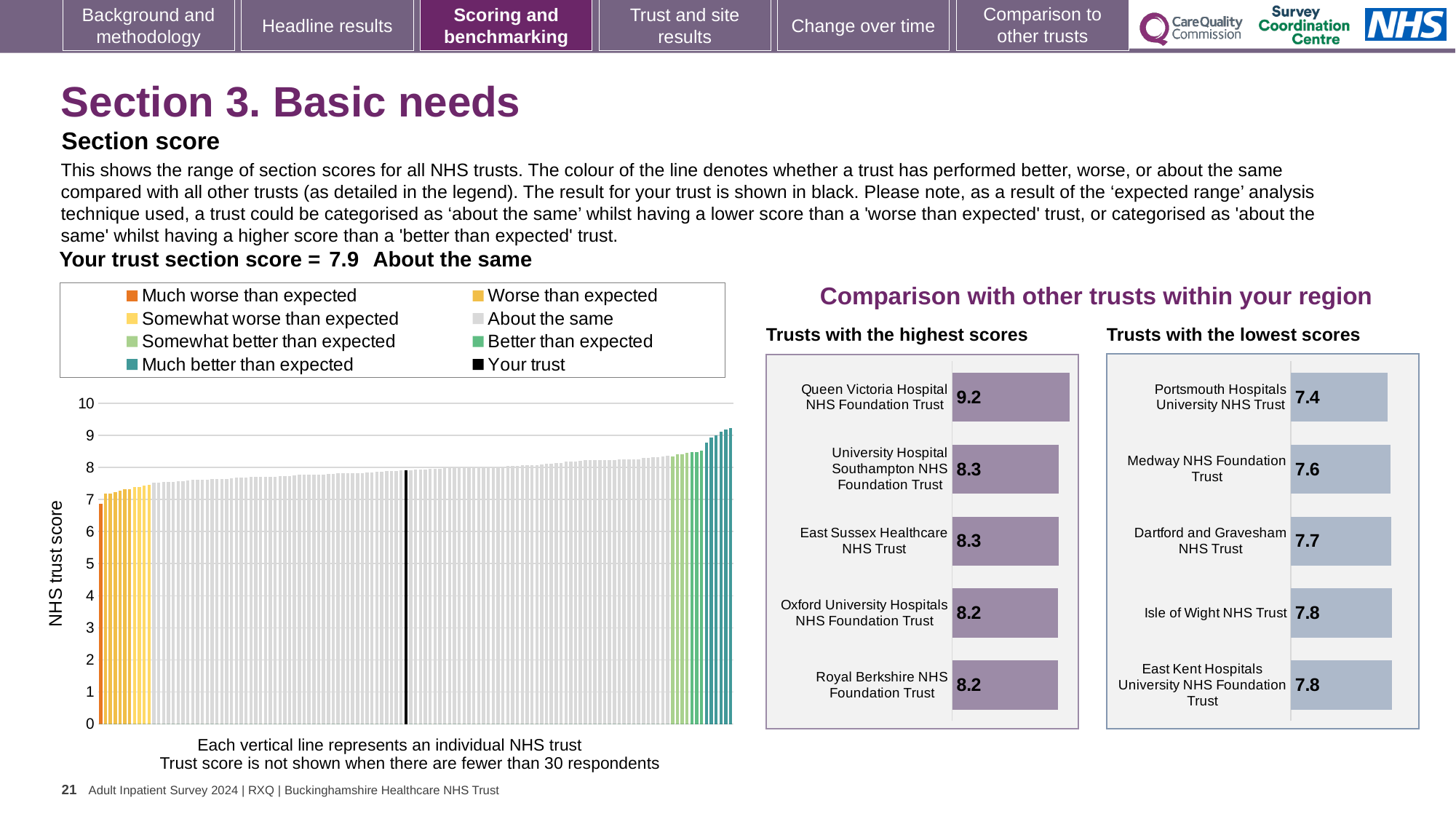
What kind of chart is the main chart on the left showing NHS trust scores? Bar chart In the 'Trusts with the lowest scores' chart, which trust has the lowest score? Portsmouth Hospitals University NHS Trust In the 'Trusts with the highest scores' chart, what is the difference between the scores of Queen Victoria Hospital NHS Foundation Trust and Royal Berkshire NHS Foundation Trust? 1.0 In the 'Trusts with the highest scores' chart, which trust has the highest score? Queen Victoria Hospital NHS Foundation Trust How many trusts are shown in the 'Trusts with the highest scores' chart? 5 In the 'Trusts with the lowest scores' chart, which has the larger score: Medway NHS Foundation Trust or Dartford and Gravesham NHS Trust? Dartford and Gravesham NHS Trust What is the section score for your trust shown on the slide? 7.9 In the main NHS trust score chart, do the values rise or fall from left to right? Rise In the 'Trusts with the highest scores' chart, what is the score for Queen Victoria Hospital NHS Foundation Trust? 9.2 How many entries does the legend of the main NHS trust score chart list? 8 In the 'Trusts with the lowest scores' chart, what is the difference between the scores of East Kent Hospitals University NHS Foundation Trust and Portsmouth Hospitals University NHS Trust? 0.4 In the 'Trusts with the lowest scores' chart, what is the score for Portsmouth Hospitals University NHS Trust? 7.4